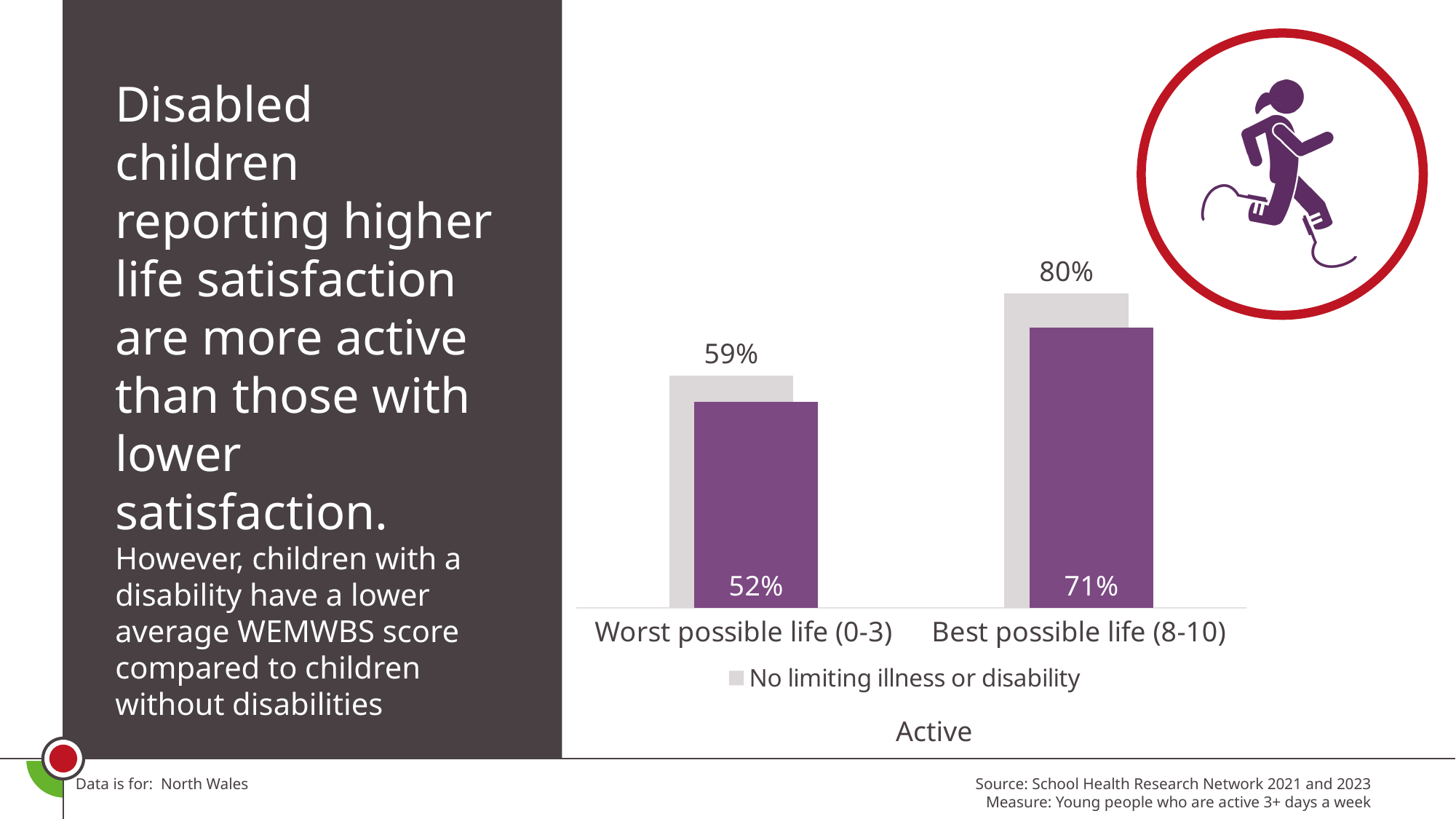
What is the difference between the 'No limiting illness or disability' values for 'Best possible life (8-10)' and 'Worst possible life (0-3)'? 21 percentage points What is the difference between the grey and purple bars for 'Best possible life (8-10)'? 9 percentage points What is the value of the 'No limiting illness or disability' bar for 'Best possible life (8-10)'? 80% Which is larger: the purple bar for 'Best possible life (8-10)' or the grey bar for 'Worst possible life (0-3)'? The purple bar for Best possible life (8-10) What is the value of the purple bar for 'Best possible life (8-10)'? 71% How many categories are shown on the x axis? 2 What is the value of the 'No limiting illness or disability' bar for 'Worst possible life (0-3)'? 59% Which category has the highest 'No limiting illness or disability' value? Best possible life (8-10) What type of chart is shown? Bar chart Which bar on the chart has the lowest value? The purple bar for Worst possible life (0-3), 52% How many series does the legend list? 1 What is the value of the purple bar for 'Worst possible life (0-3)'? 52%